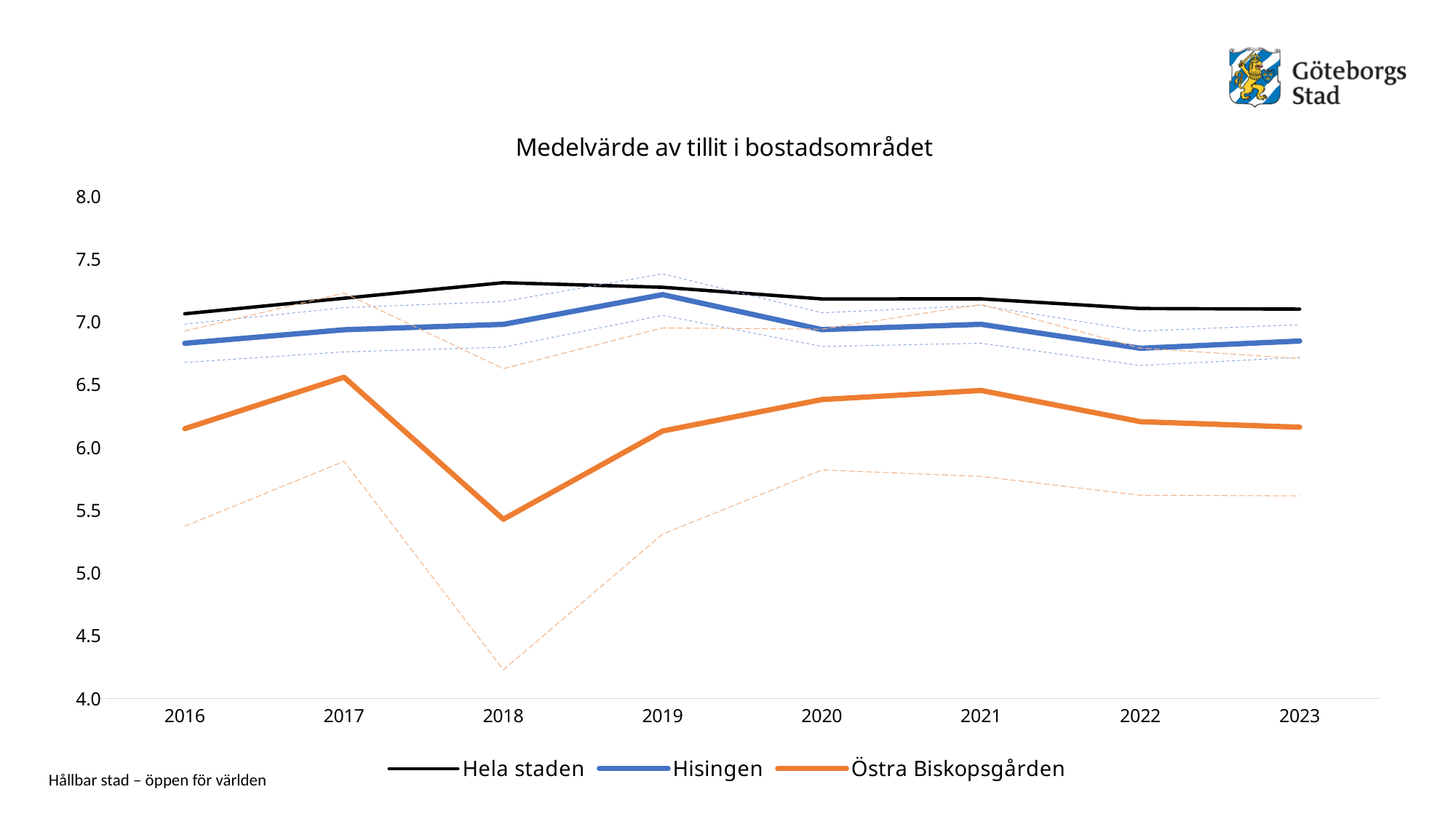
How many years are plotted along the x axis? 8 Which is larger in 2023, the value for Hisingen or the value for Östra Biskopsgården? Hisingen How many series does the legend list? 3 Is the value for Östra Biskopsgården in 2018 greater or less than 6.0? less Does the value for Östra Biskopsgården rise or fall from 2017 to 2018? fall In which year is the value for Hisingen highest? 2019 In which year is the value for Östra Biskopsgården lowest? 2018 What kind of chart is shown on the slide? line chart Which series is drawn in orange? Östra Biskopsgården Is the value for Hisingen in 2019 greater or less than 7.0? greater What is the title of the chart? Medelvärde av tillit i bostadsområdet